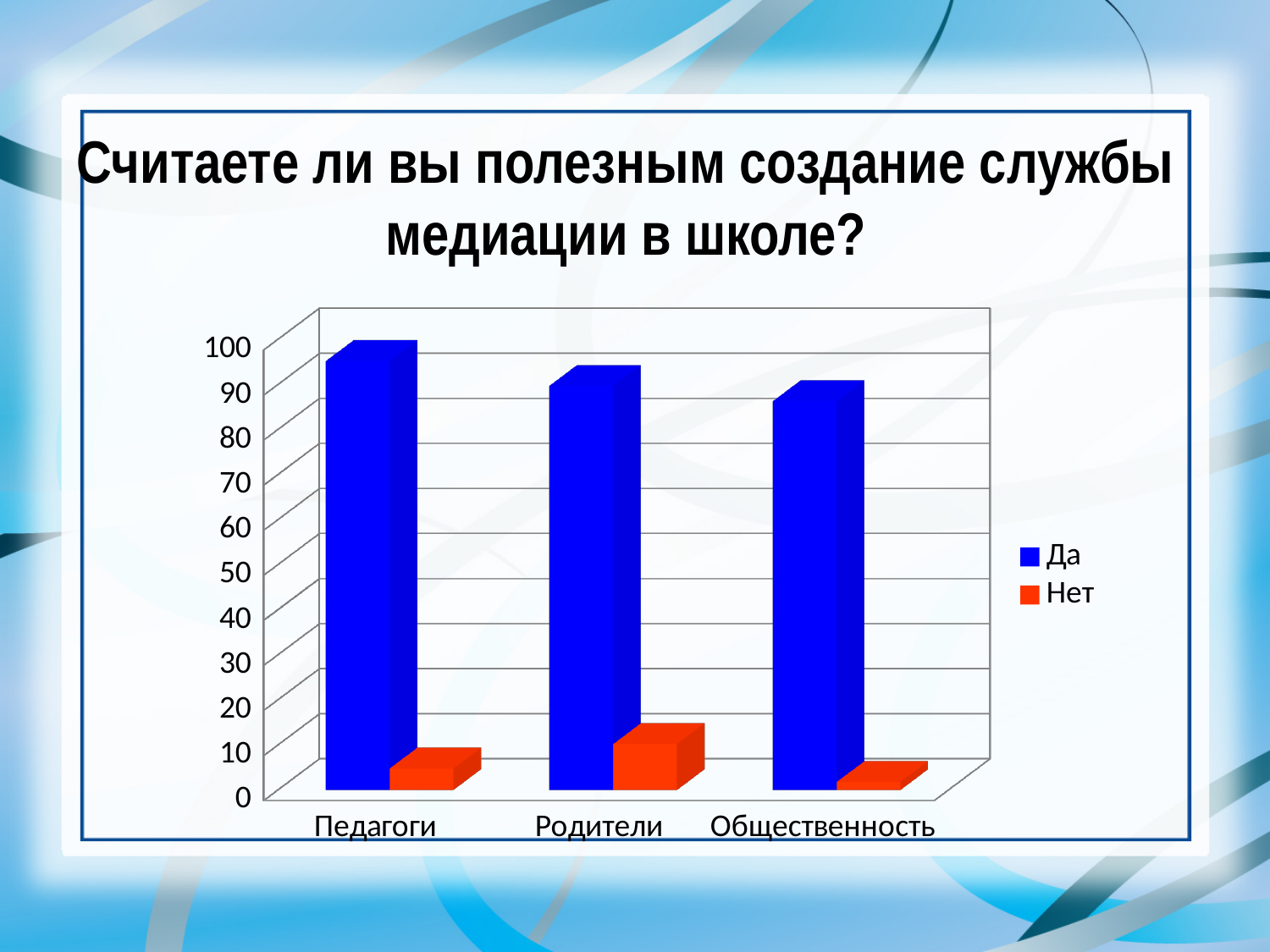
Which category has the highest value for the Да series? Педагоги Is the Нет value for Родители greater or less than 20? less What kind of chart is shown on the slide? bar chart How many series does the chart legend list? 2 Is the Нет value for Педагоги greater or less than 10? less What is the title of the chart? Считаете ли вы полезным создание службы медиации в школе? What are the series names listed in the chart legend? Да, Нет Which category has the highest value for the Нет series? Родители For Родители, which is larger: the Да value or the Нет value? Да How many categories are shown on the x axis of the chart? 3 Is the Да value for Общественность greater or less than 80? greater